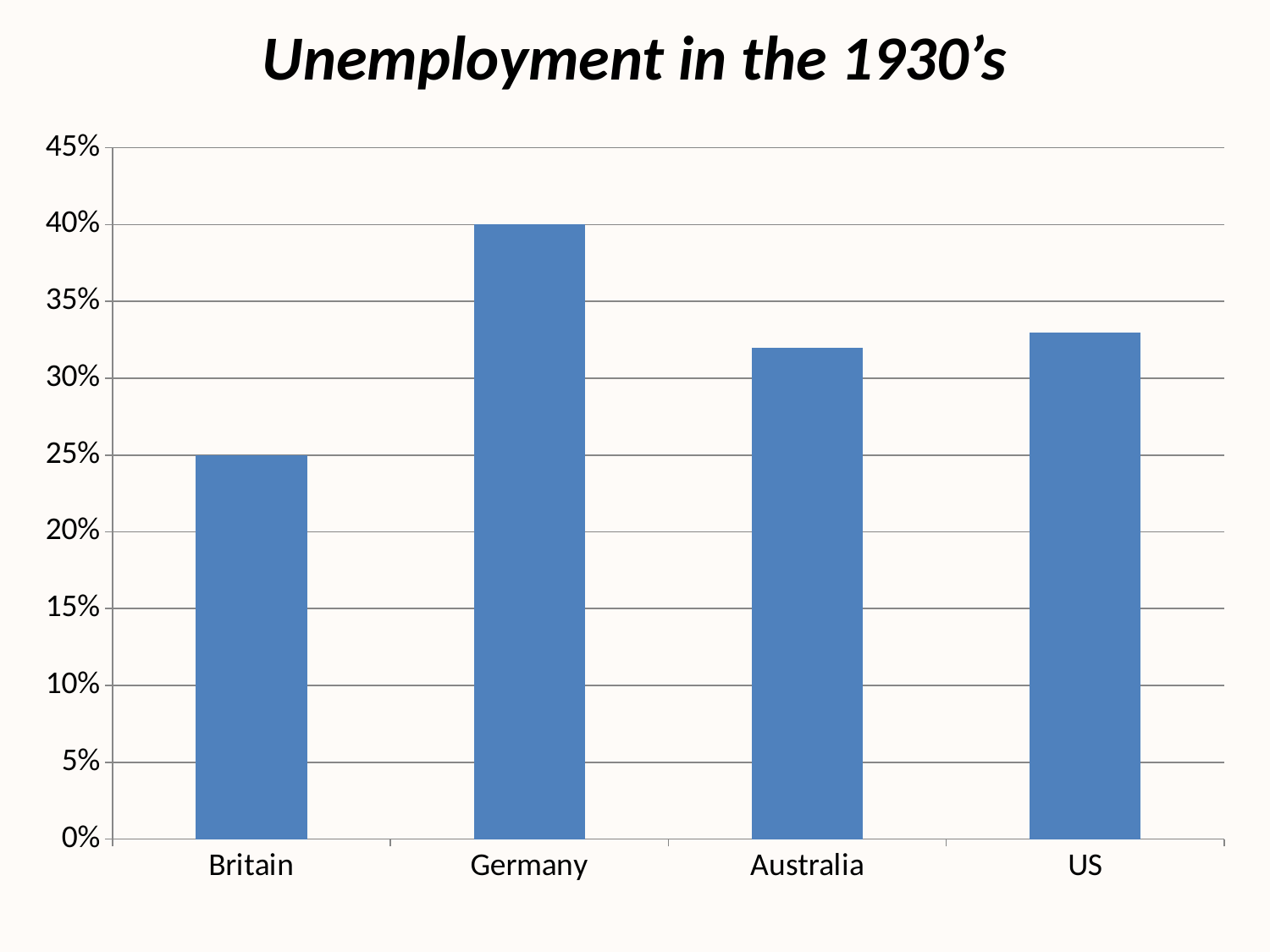
What kind of chart is shown on the slide? Bar chart What is the difference between the unemployment rates of Germany and Britain? 15% Which has a higher unemployment rate, Germany or the US? Germany Which has a higher unemployment rate, Britain or Australia? Australia Is the value for the US greater or less than 35%? less Which country has the highest unemployment rate on the chart? Germany What is the title of the chart? Unemployment in the 1930's What is the unemployment rate shown for Britain? 25% What is the unemployment rate shown for Germany? 40% Which country has the lowest unemployment rate on the chart? Britain How many countries are shown on the chart? 4 Is the value for Australia greater or less than 30%? greater